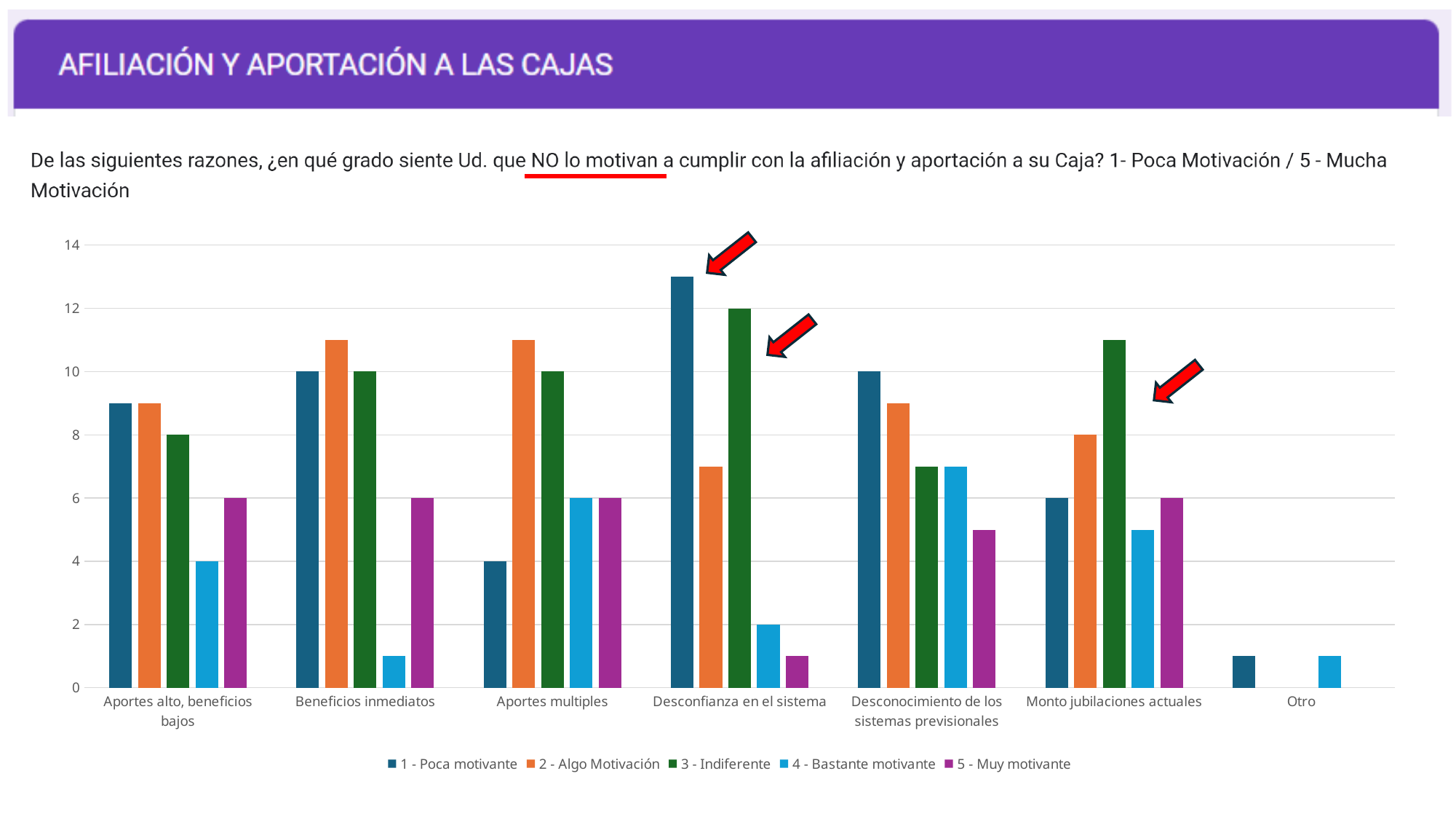
How many categories are shown on the x axis? 7 What is the value for '4 - Bastante motivante' in the 'Aportes alto, beneficios bajos' category? 4 In the 'Desconfianza en el sistema' category, what is the difference between '3 - Indiferente' and '4 - Bastante motivante'? 10 What is the value for '1 - Poca motivante' in the 'Beneficios inmediatos' category? 10 What type of chart is shown on the slide? bar chart Which category has the tallest bar in the chart? Desconfianza en el sistema How many series does the legend list? 5 What is the value for '3 - Indiferente' in the 'Desconfianza en el sistema' category? 12 Is the value for '1 - Poca motivante' in 'Desconfianza en el sistema' greater or less than 12? greater Is the value for '3 - Indiferente' in 'Monto jubilaciones actuales' greater or less than 10? greater What is the value for '2 - Algo Motivación' in the 'Monto jubilaciones actuales' category? 8 In the 'Aportes multiples' category, which is larger: '1 - Poca motivante' or '2 - Algo Motivación'? 2 - Algo Motivación